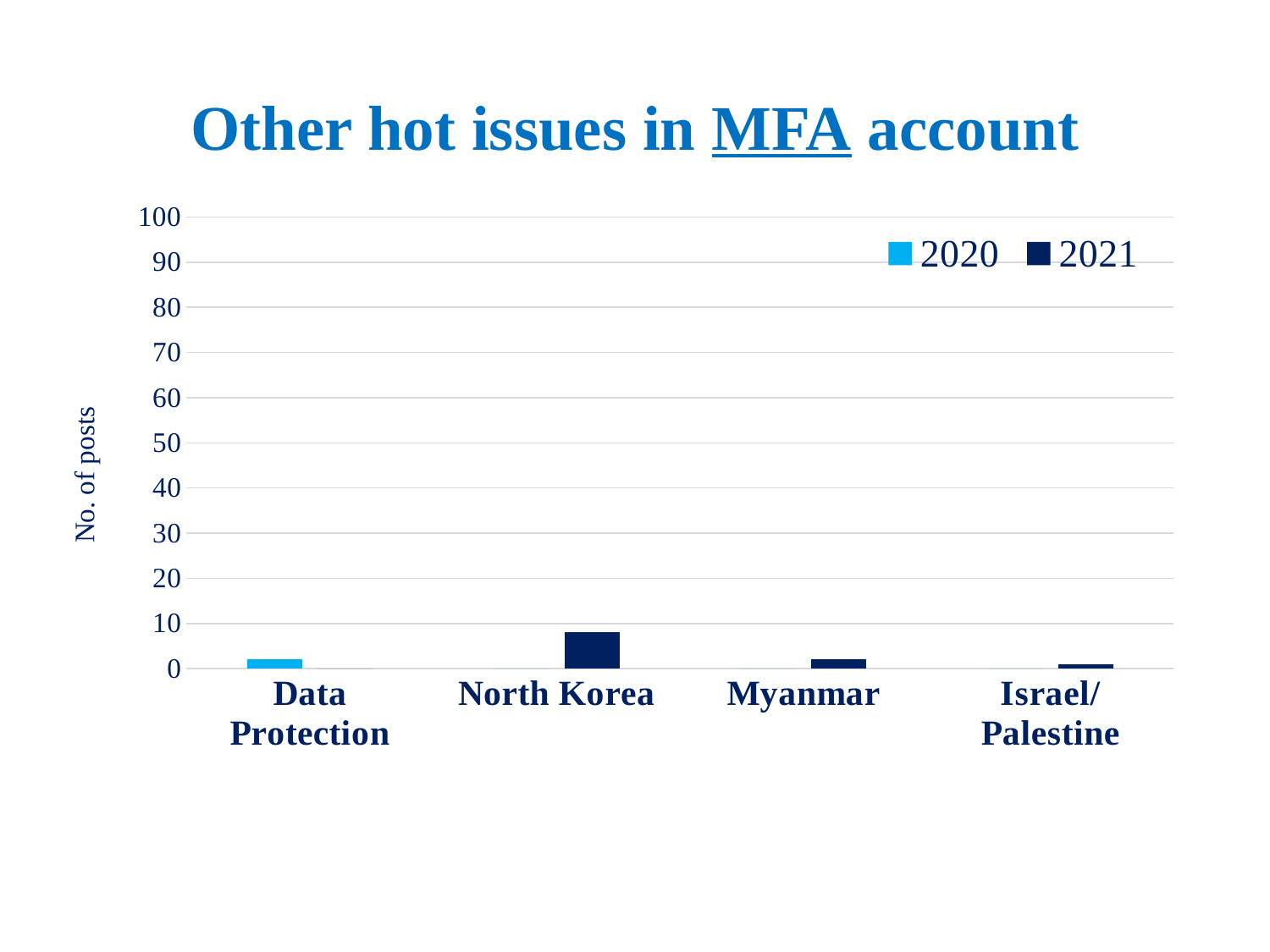
Is the 2021 value for North Korea greater or less than 10? less What is the label on the y axis? No. of posts Is the 2021 value for North Korea greater or less than 5? greater What kind of chart is shown on the slide? bar chart How many series does the legend list? 2 Which is larger for Data Protection, the 2020 value or the 2021 value? 2020 Is the 2021 value for Myanmar greater or less than 10? less Which is larger, the 2021 value for North Korea or the 2021 value for Myanmar? North Korea How many categories are shown on the x axis? 4 Which category has the highest 2021 value? North Korea What is the title of the chart on the slide? Other hot issues in MFA account